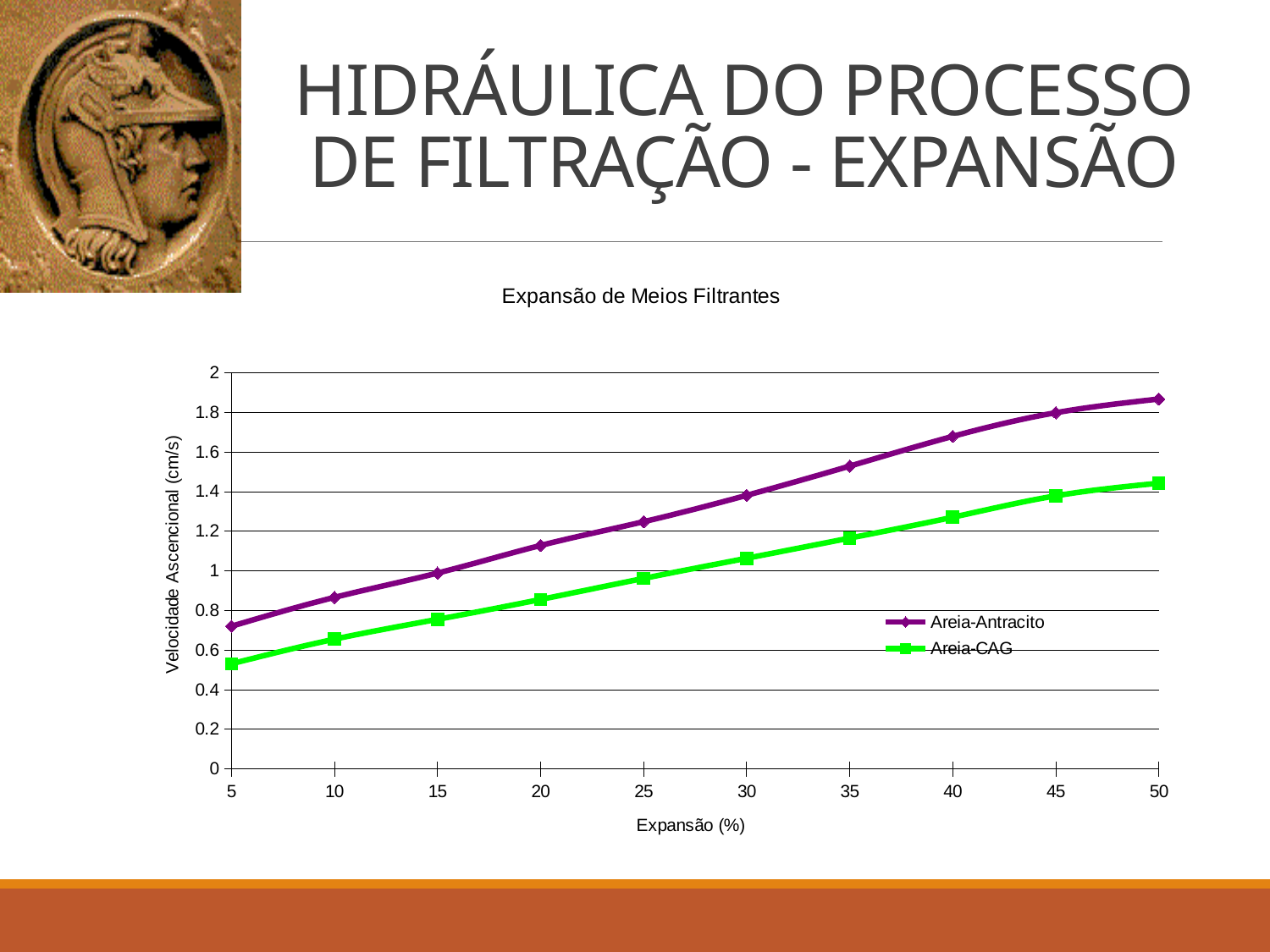
Do the values for Areia-Antracito rise or fall as Expansão (%) increases? rise How many series does the legend list? 2 Is the value for Areia-Antracito at 5% expansion greater or less than 0.8? less At 30% expansion, which series has the larger value, Areia-Antracito or Areia-CAG? Areia-Antracito What is the title of the chart? Expansão de Meios Filtrantes Is the value for Areia-Antracito at 50% expansion greater or less than 1.8? greater Is the value for Areia-Antracito at 40% expansion greater or less than 1.6? greater What is the label of the y axis? Velocidade Ascencional (cm/s) What kind of chart is shown on the slide? line chart How many expansion values are plotted along the x axis for each series? 10